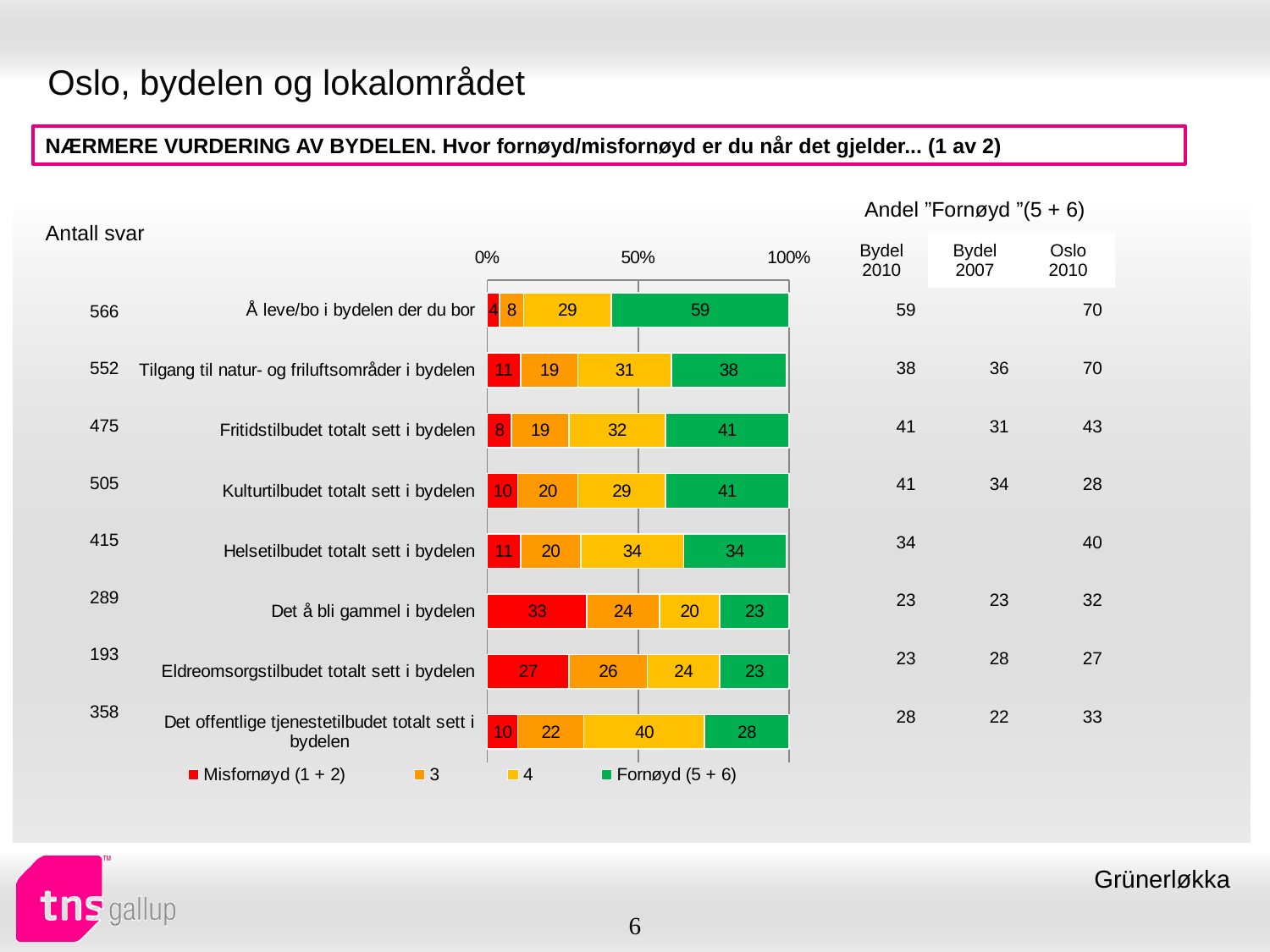
What is the difference between the Fornøyd (5 + 6) values for "Å leve/bo i bydelen der du bor" and "Tilgang til natur- og friluftsområder i bydelen"? 21 How many series does the legend list? 4 Which has a larger Fornøyd (5 + 6) value: "Helsetilbudet totalt sett i bydelen" or "Kulturtilbudet totalt sett i bydelen"? Kulturtilbudet totalt sett i bydelen What is the value of the "4" segment for "Det offentlige tjenestetilbudet totalt sett i bydelen"? 40 What is the value of the Fornøyd (5 + 6) segment for "Å leve/bo i bydelen der du bor"? 59 Which category has the lowest Misfornøyd (1 + 2) value? Å leve/bo i bydelen der du bor How many categories are shown in the bar chart? 8 Which category has the highest Fornøyd (5 + 6) value? Å leve/bo i bydelen der du bor What is the value of the Misfornøyd (1 + 2) segment for "Det å bli gammel i bydelen"? 33 Which category has the highest Misfornøyd (1 + 2) value? Det å bli gammel i bydelen What kind of chart is shown on the slide? Stacked bar chart What is the total of the stacked bar for "Det å bli gammel i bydelen"? 100